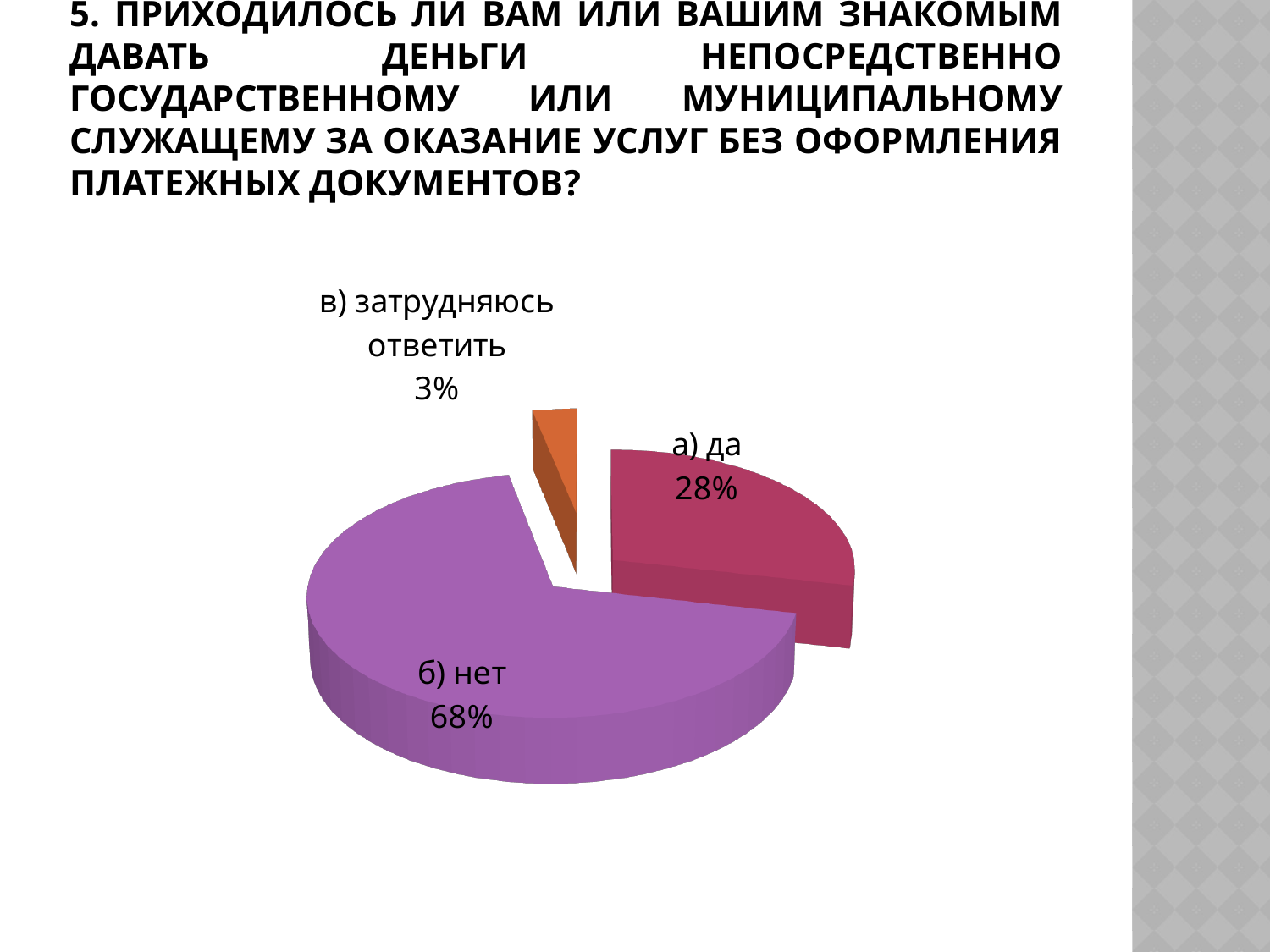
What share of respondents answered "б) нет"? 68% What colour is the slice for "б) нет"? purple Which answer option has the smallest share of the pie? в) затрудняюсь ответить What colour is the slice for "в) затрудняюсь ответить"? orange What is the difference in percentage points between "а) да" and "в) затрудняюсь ответить"? 25 What kind of chart is shown on the slide? pie chart Which answer option has the largest share of the pie? б) нет What share of respondents answered "а) да"? 28% How many slices does the pie chart have? 3 What share of respondents answered "в) затрудняюсь ответить"? 3% What is the difference in percentage points between "б) нет" and "а) да"? 40 Which is larger: the share for "а) да" or the share for "в) затрудняюсь ответить"? а) да